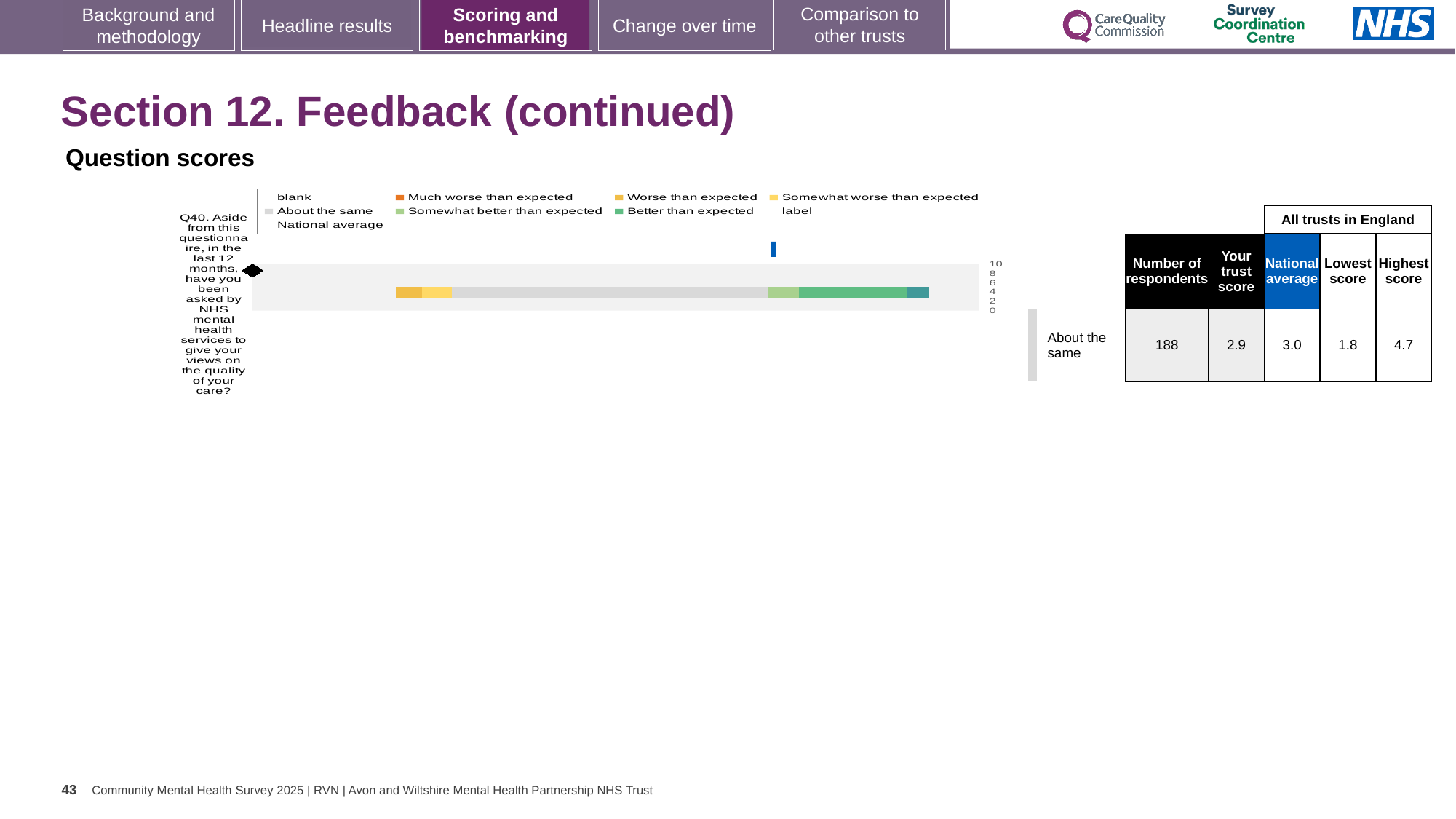
What colour does the legend use for 'Much worse than expected'? orange In the table beside the chart, how many respondents answered Q40? 188 How many entries does the chart legend list? 9 For Q40, which is larger: the trust score or the National average? National average How many questions (categories) are plotted in the bar chart? 1 What kind of chart is shown under 'Question scores'? bar chart In the table beside the chart, what is the Lowest score among all trusts in England for Q40? 1.8 For Q40, what is the difference between the Highest score and the Lowest score in the table? 2.9 In the table beside the chart, what is the Highest score among all trusts in England for Q40? 4.7 Which question number is plotted in the bar chart? Q40 In the table beside the chart, what is 'Your trust score' for Q40? 2.9 In the table beside the chart, what is the National average for Q40? 3.0